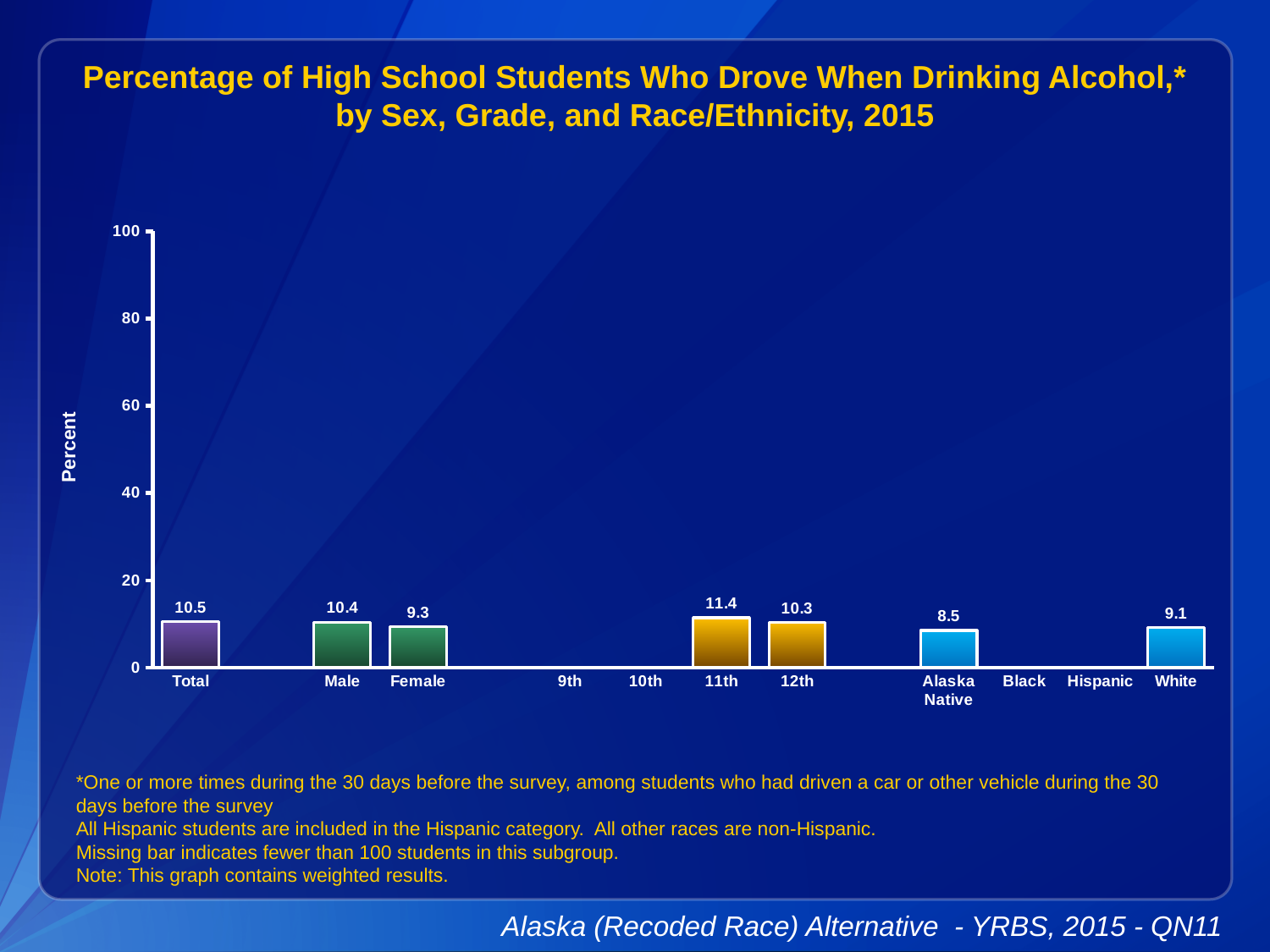
What is the value for Total? 10.5 What is the value for Male? 10.4 Which categories on the x axis have no bar shown? 9th, 10th, Black, Hispanic Is the value for Total greater or less than 20? less What is the value for 11th grade? 11.4 What is the value for Alaska Native? 8.5 Which category has the highest value among the bars shown? 11th Which category has the lowest value among the bars shown? Alaska Native What is the difference between the values for 11th and 12th grade? 1.1 What is the difference between the values for Male and Female? 1.1 Which is larger, the value for Female or the value for White? Female What kind of chart is shown on the slide? bar chart